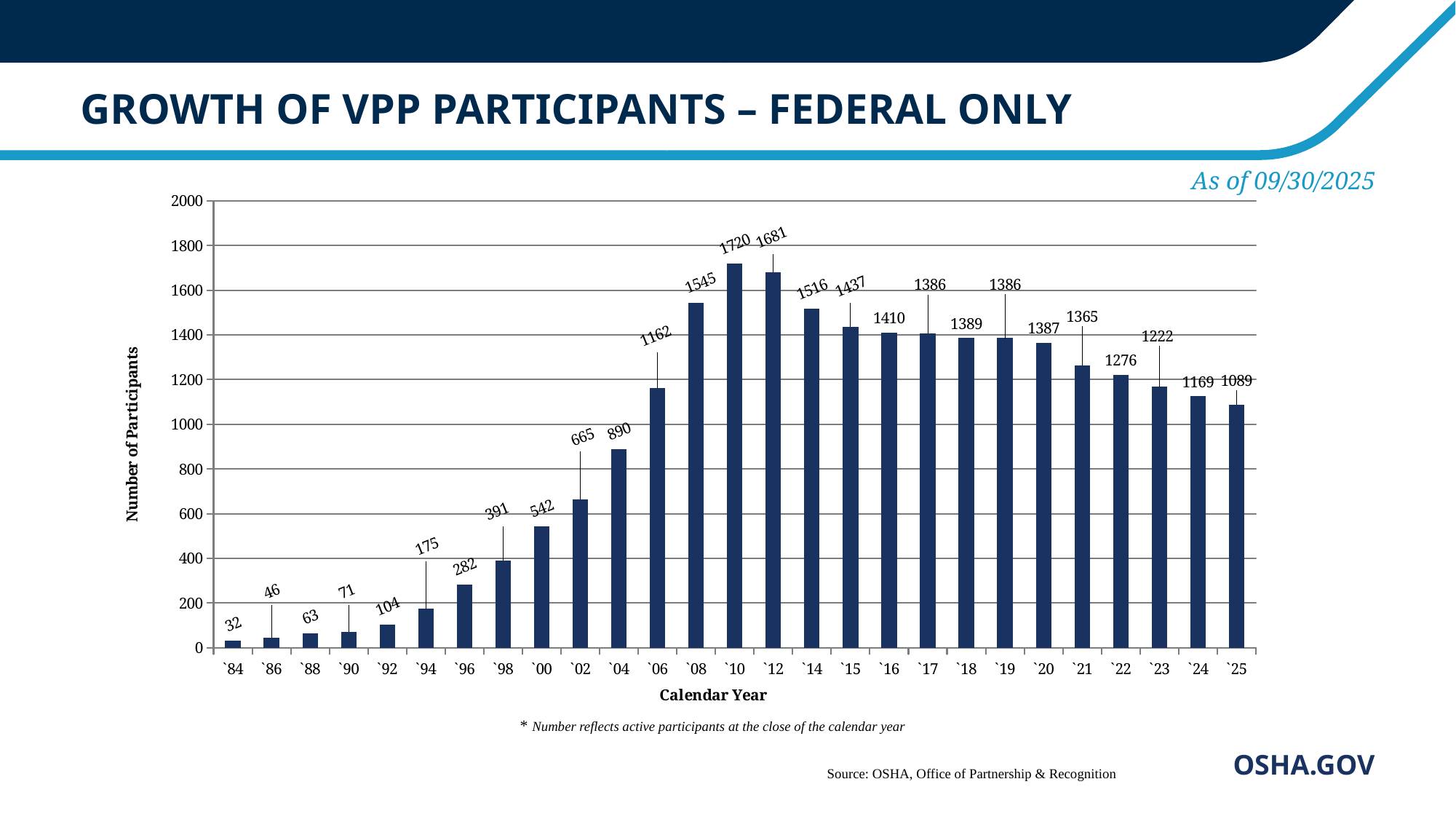
What is the number of participants for `98? 391 What is the difference in participants between `24 and `25? 80 What is the number of participants for `10? 1720 Which calendar year has the lowest number of participants? `84 What is the title of the chart on the slide? Growth of VPP Participants – Federal Only Which calendar year has the highest number of participants? `10 What is the number of participants for `25? 1089 Which year has more participants, `08 or `06? `08 What kind of chart is shown on the slide? Bar chart What is the difference in participants between `10 and `12? 39 Do the values rise or fall from `84 to `10? Rise How many calendar years are shown on the x axis? 27